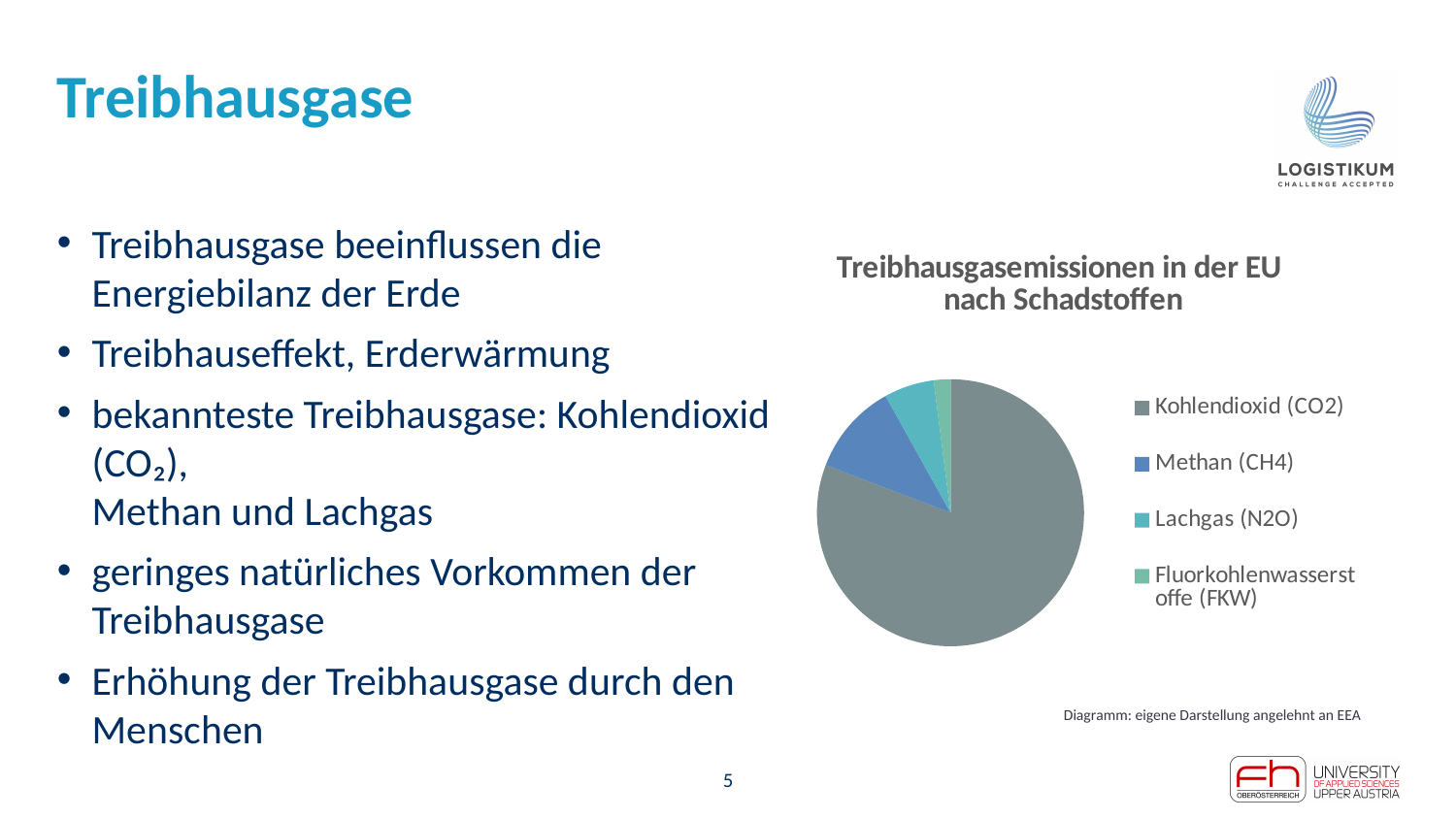
Which category is listed second in the chart legend? Methan (CH4) Which category has the largest slice of the pie? Kohlendioxid (CO2) Which slice is larger, Kohlendioxid (CO2) or Methan (CH4)? Kohlendioxid (CO2) What kind of chart is shown on the slide? pie chart What is the title of the chart? Treibhausgasemissionen in der EU nach Schadstoffen Which category has the smallest slice of the pie? Fluorkohlenwasserstoffe (FKW) Which slice is larger, Lachgas (N2O) or Fluorkohlenwasserstoffe (FKW)? Lachgas (N2O) Which slice is larger, Methan (CH4) or Lachgas (N2O)? Methan (CH4) How many categories does the pie chart show? 4 Which category has the second-largest slice of the pie? Methan (CH4)